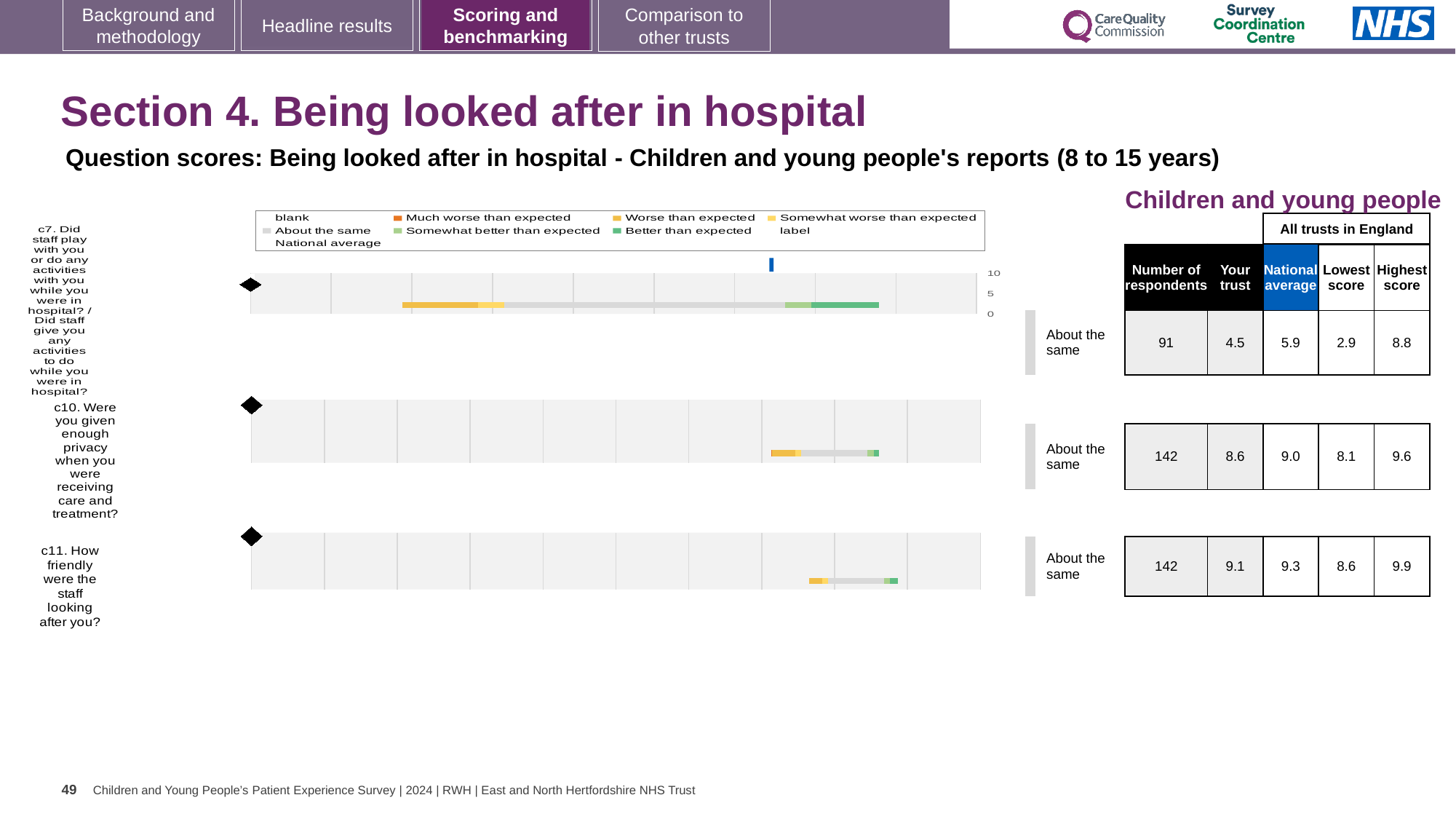
Which question has the lowest 'Lowest score' among all trusts in England? c7. Did staff play with you or do any activities with you while you were in hospital? What is the highest score across all trusts in England for question c11 (how friendly were the staff)? 9.9 Which question has the highest 'Your trust' score? c11. How friendly were the staff looking after you? How many respondents answered question c7? 91 What is the 'Your trust' score for question c7 (staff playing or doing activities with you)? 4.5 What benchmark category is shown for question c10? About the same What kind of chart is used to show the expected-range benchmarking for each question? Bar chart How many survey questions are plotted as rows in the benchmarking chart? 3 What is the difference between the highest and lowest trust scores for question c10? 1.5 By how much does the national average exceed the trust's score for question c7? 1.4 For question c11, which is larger: the trust's score or the national average? National average What is the national average score for question c10 (enough privacy when receiving care and treatment)? 9.0